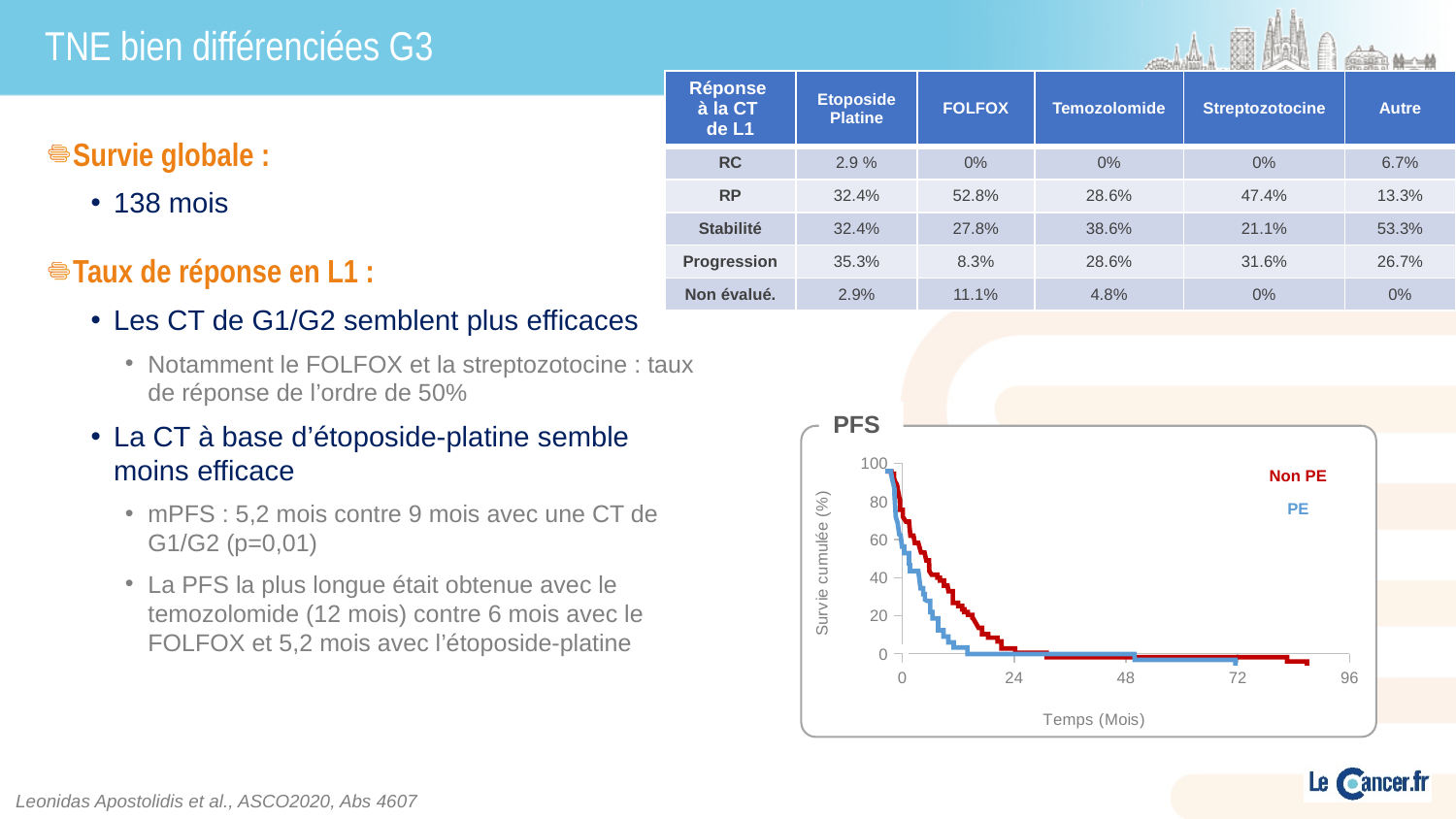
What is the label of the x axis of the PFS chart? Temps (Mois) Which series in the PFS chart is drawn in red? Non PE In the PFS chart, is the cumulative survival of the Non PE series at 24 months greater or less than 40? less What is the highest value shown on the x axis of the PFS chart? 96 What is the label of the y axis of the PFS chart? Survie cumulée (%) What kind of chart is the PFS chart on the slide? line chart What are the two series shown in the PFS chart? Non PE and PE In the PFS chart, is the cumulative survival of the PE series at 24 months greater or less than 20? less How many series does the legend of the PFS chart list? 2 What is the title of the chart on the slide? PFS In the PFS chart, do the curves rise or fall as time increases along the x axis? fall In the PFS chart, which series has the higher cumulative survival at 12 months, Non PE or PE? Non PE